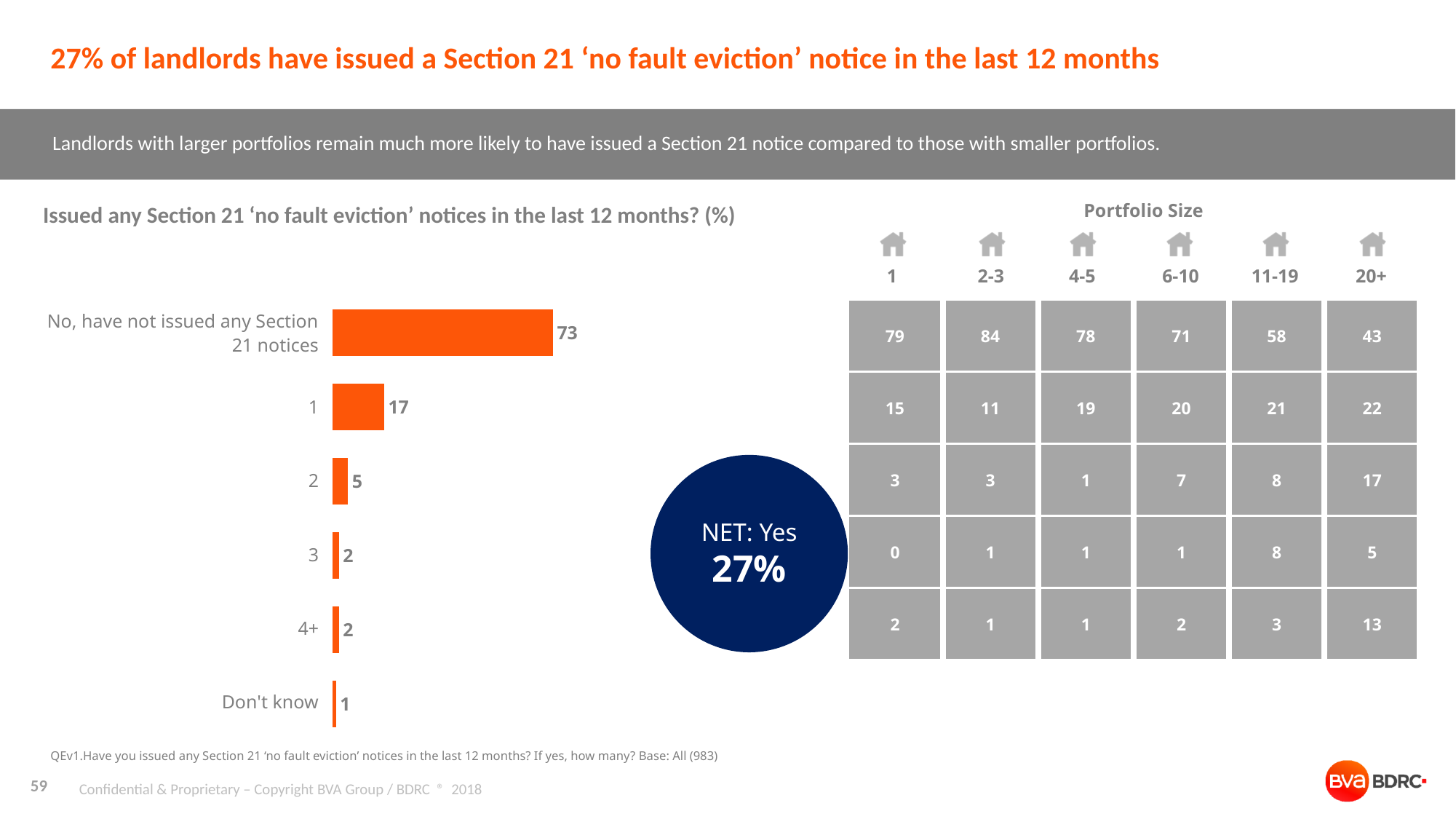
What is the difference between the values for 'No, have not issued any Section 21 notices' and '1'? 56 What is the difference between the values for '1' and '2'? 12 Which category has the highest value in the bar chart? No, have not issued any Section 21 notices What is the value for 'No, have not issued any Section 21 notices'? 73 What is the value for 'Don't know'? 1 What kind of chart is shown on the slide? bar chart Which is larger, the value for '2' or the value for '3'? The value for '2' (5, versus 2 for '3') What is the value for the category '1' in the bar chart? 17 Which category has the lowest value in the bar chart? Don't know How many categories are shown in the bar chart? 6 What is the title of the bar chart? Issued any Section 21 ‘no fault eviction’ notices in the last 12 months? (%) What is the value for the category '2' in the bar chart? 5